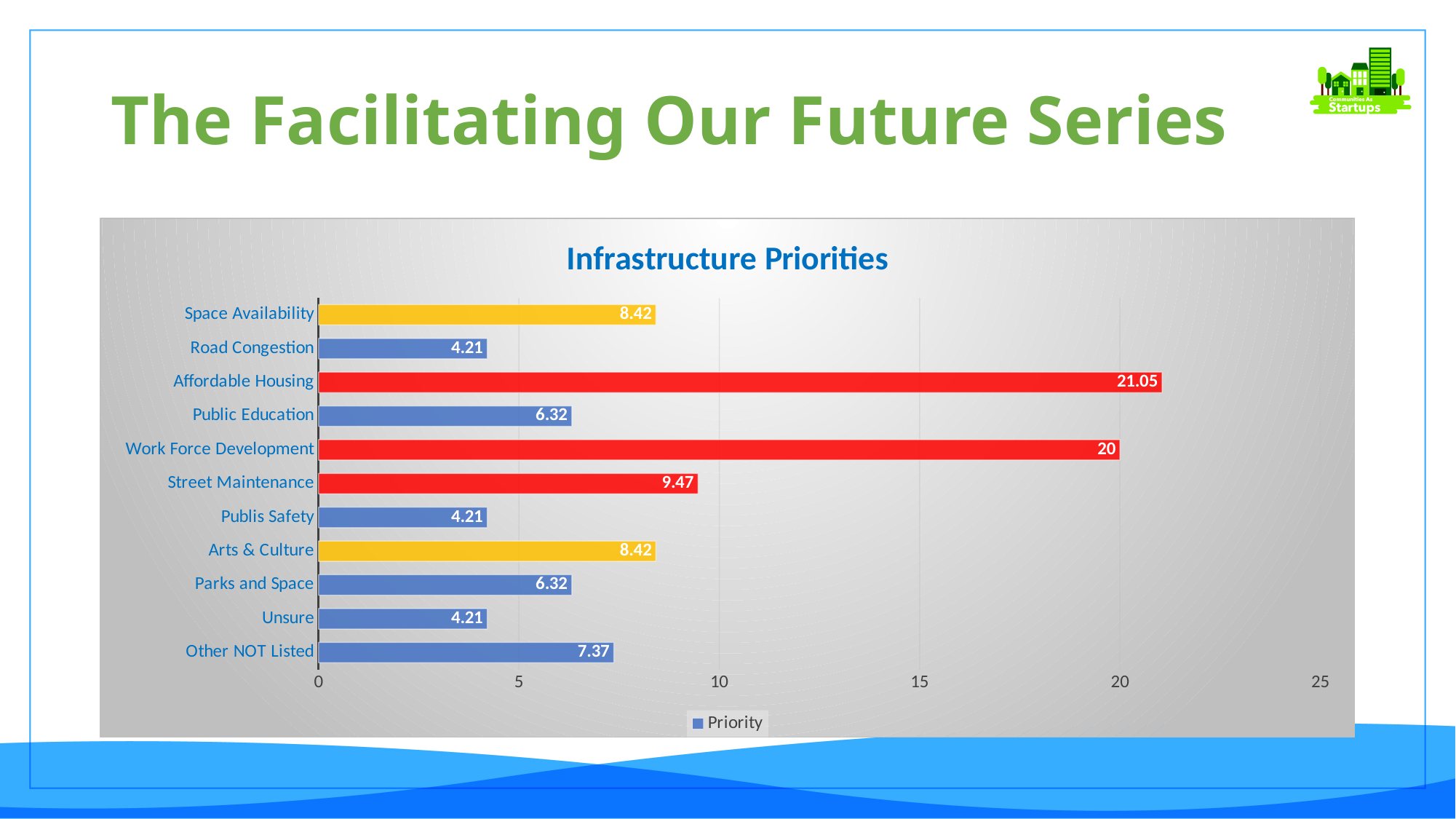
What is the difference between the values for Street Maintenance and Public Education? 3.15 What is the value for Work Force Development in the Infrastructure Priorities chart? 20 How many categories are shown in the Infrastructure Priorities chart? 11 What is the difference between the values for Affordable Housing and Work Force Development? 1.05 What is the value for Affordable Housing in the Infrastructure Priorities chart? 21.05 What is the value for Other NOT Listed in the Infrastructure Priorities chart? 7.37 Which has a larger value, Space Availability or Other NOT Listed? Space Availability Which category has the highest value in the Infrastructure Priorities chart? Affordable Housing What is the value for Street Maintenance in the Infrastructure Priorities chart? 9.47 How many series does the legend of the Infrastructure Priorities chart list? 1 Is the value for Street Maintenance greater or less than 10? less What type of chart is the Infrastructure Priorities chart? Bar chart